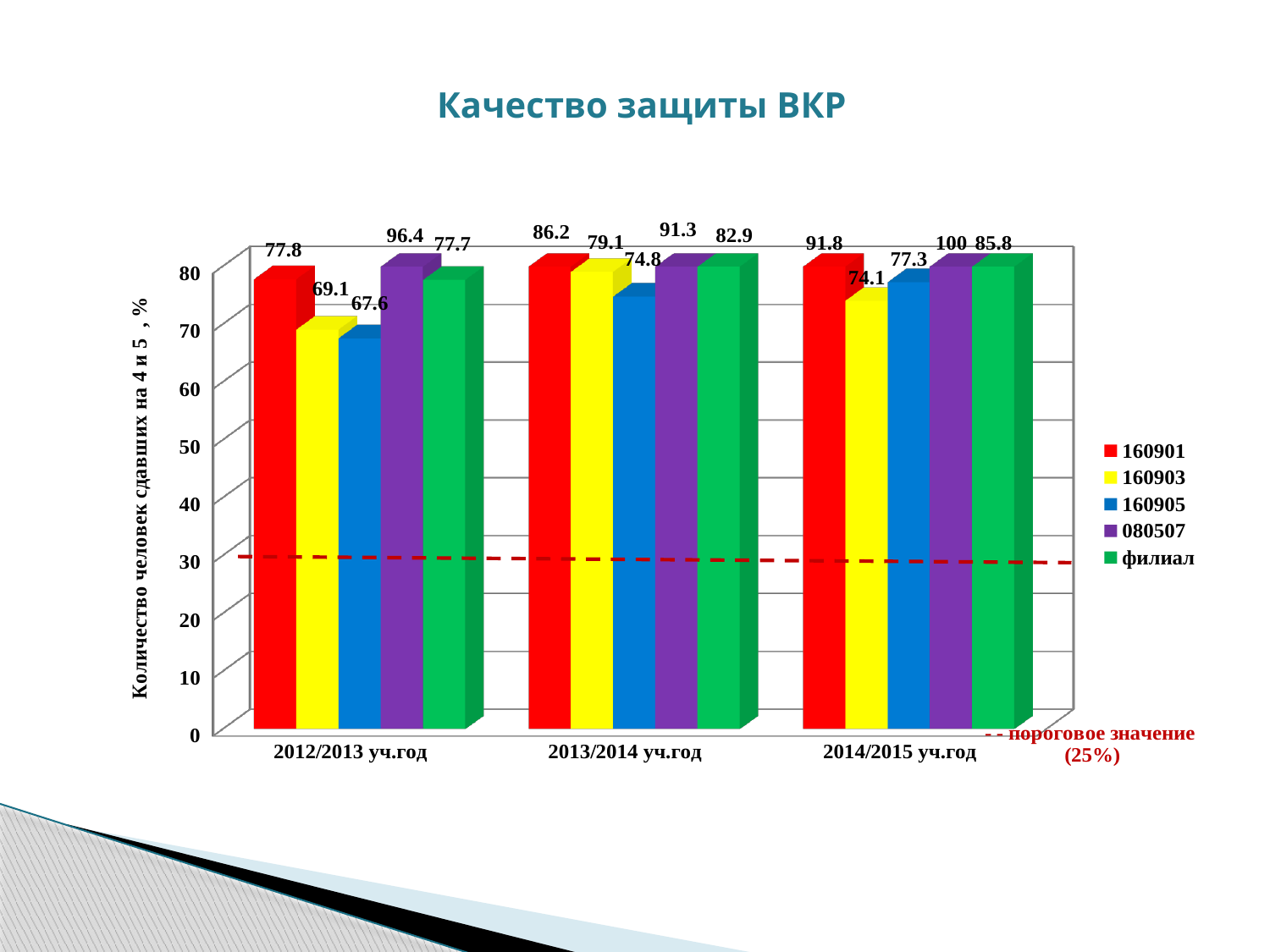
What is the value for series 080507 in 2014/2015 уч.год? 100 Which is larger: the value for 160903 in 2013/2014 уч.год or the value for 160905 in 2014/2015 уч.год? 160903 in 2013/2014 уч.год What is the value for series филиал in 2013/2014 уч.год? 82.9 What is the value for series 160901 in 2012/2013 уч.год? 77.8 Which series has the lowest value in 2012/2013 уч.год? 160905 Which series has the highest value in 2013/2014 уч.год? 080507 What is the title of the chart? Качество защиты ВКР What kind of chart is shown on the slide? bar chart How many academic-year categories are shown on the x axis? 3 How many series does the legend list? 5 What is the difference between the values for 160901 in 2014/2015 уч.год and 2012/2013 уч.год? 14 Does the value for series 160901 rise or fall from 2012/2013 уч.год to 2014/2015 уч.год? rise